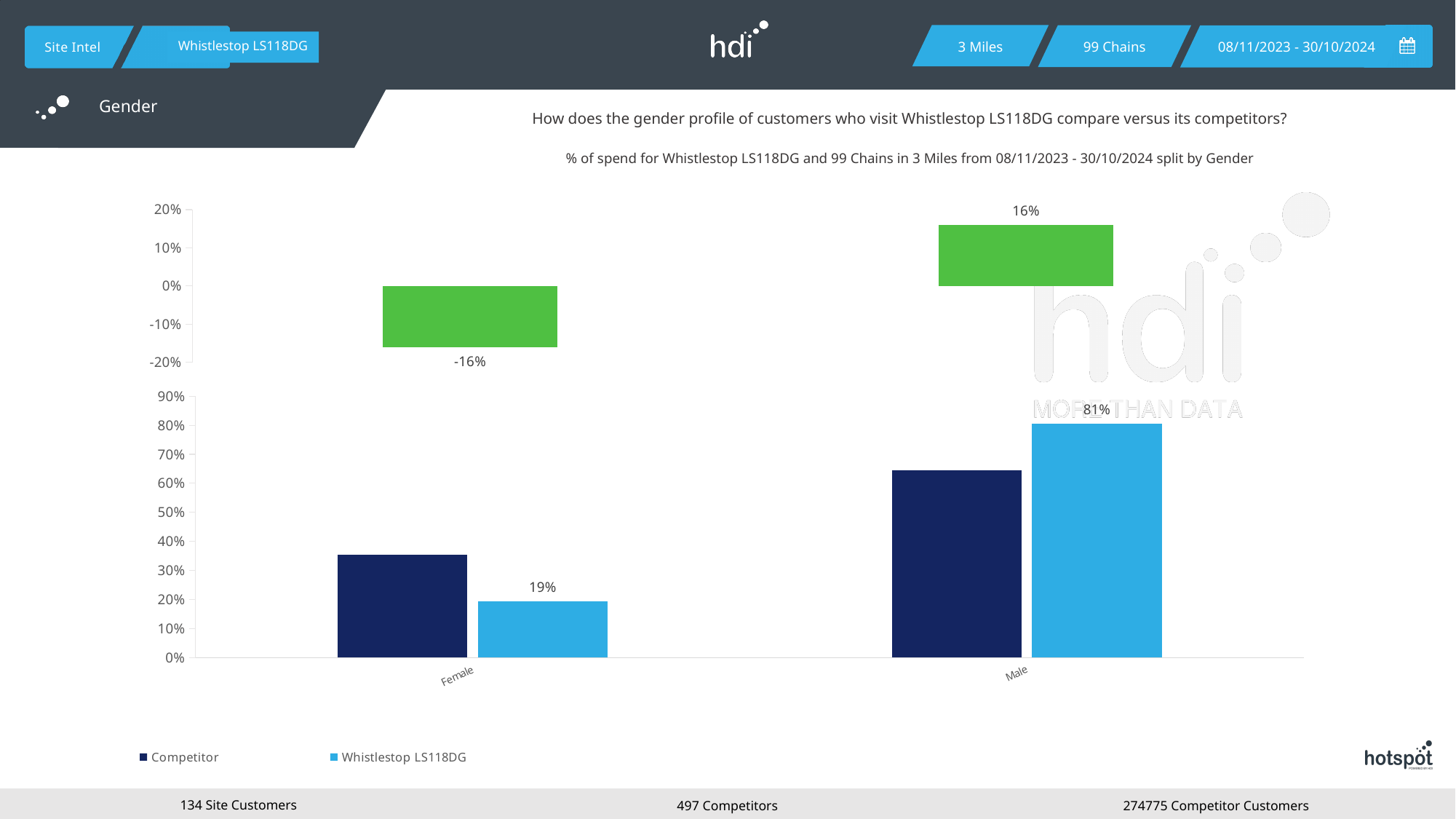
In the bottom chart, what is the value for Whistlestop LS118DG for Male? 81% In the top chart, what is the value shown for Female? -16% In the bottom chart, which is larger for Male: Competitor or Whistlestop LS118DG? Whistlestop LS118DG In the bottom chart, which is larger for Female: Competitor or Whistlestop LS118DG? Competitor In the bottom chart, is the Competitor value for Female greater or less than 30%? greater In the top chart, what is the value shown for Male? 16% How many series does the legend of the bottom chart list? 2 What kind of chart is the bottom chart? Bar chart In the bottom chart, is the Competitor value for Male greater or less than 70%? less In the bottom chart, what is the value for Whistlestop LS118DG for Female? 19% How many gender categories are shown on the x axis of the bottom chart? 2 In the bottom chart, what is the difference between the Whistlestop LS118DG values for Male and Female? 62%